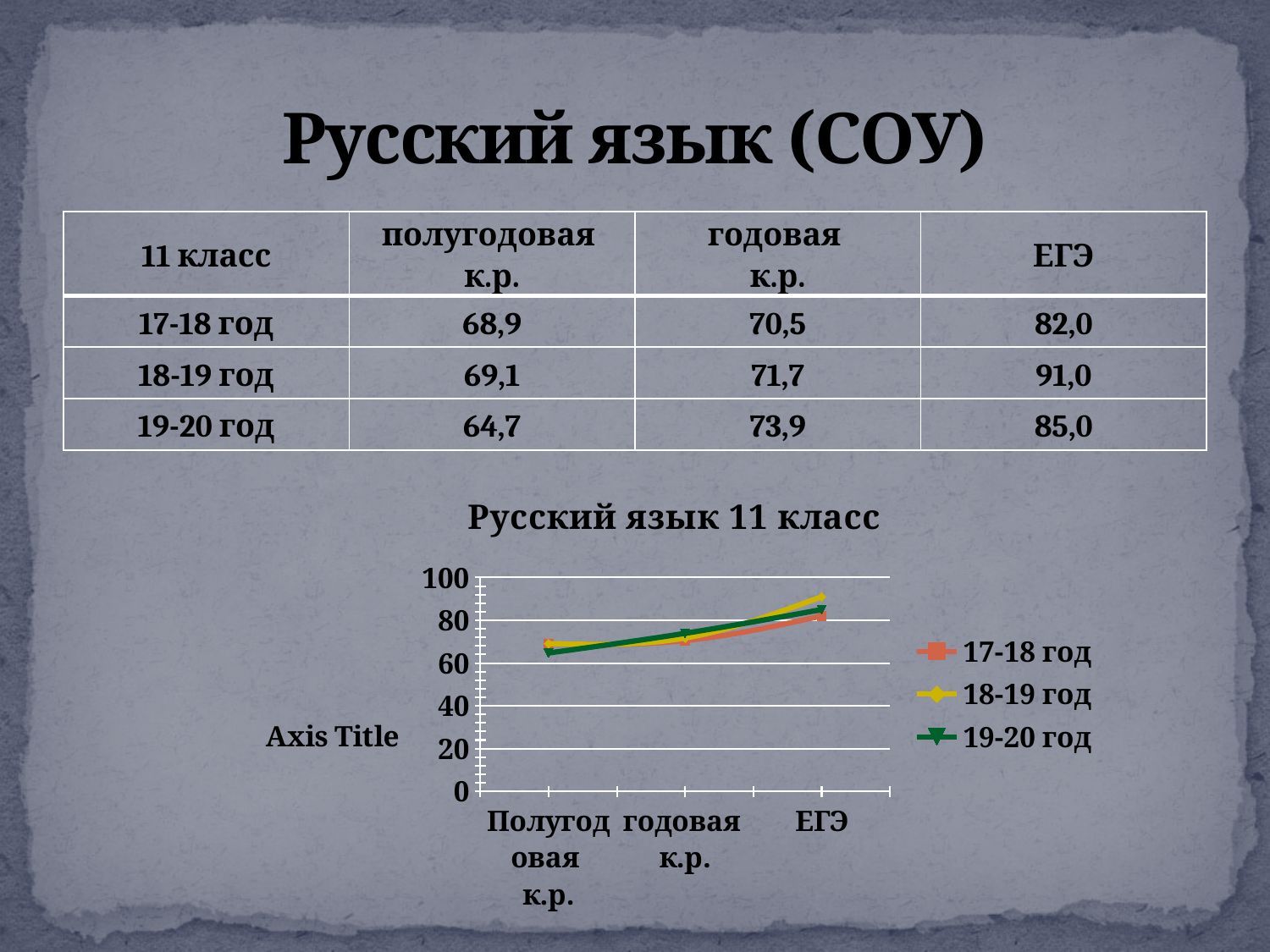
Is the value for 19-20 год at Полугодовая к.р. greater or less than 80? less How many categories are plotted along the x axis of the chart? 3 How many series does the chart legend list? 3 Do the values for the 18-19 год series rise or fall from Полугодовая к.р. to ЕГЭ? rise Is the value for 18-19 год at ЕГЭ greater or less than 80? greater Which series has the highest value at ЕГЭ? 18-19 год What kind of chart is shown on the slide? line chart Which series has the lowest value at Полугодовая к.р.? 19-20 год What is the title of the chart? Русский язык 11 класс What is the value for 18-19 год at ЕГЭ? 91,0 What is the value for 19-20 год at годовая к.р.? 73,9 What is the difference between the ЕГЭ values for 18-19 год and 17-18 год? 9,0